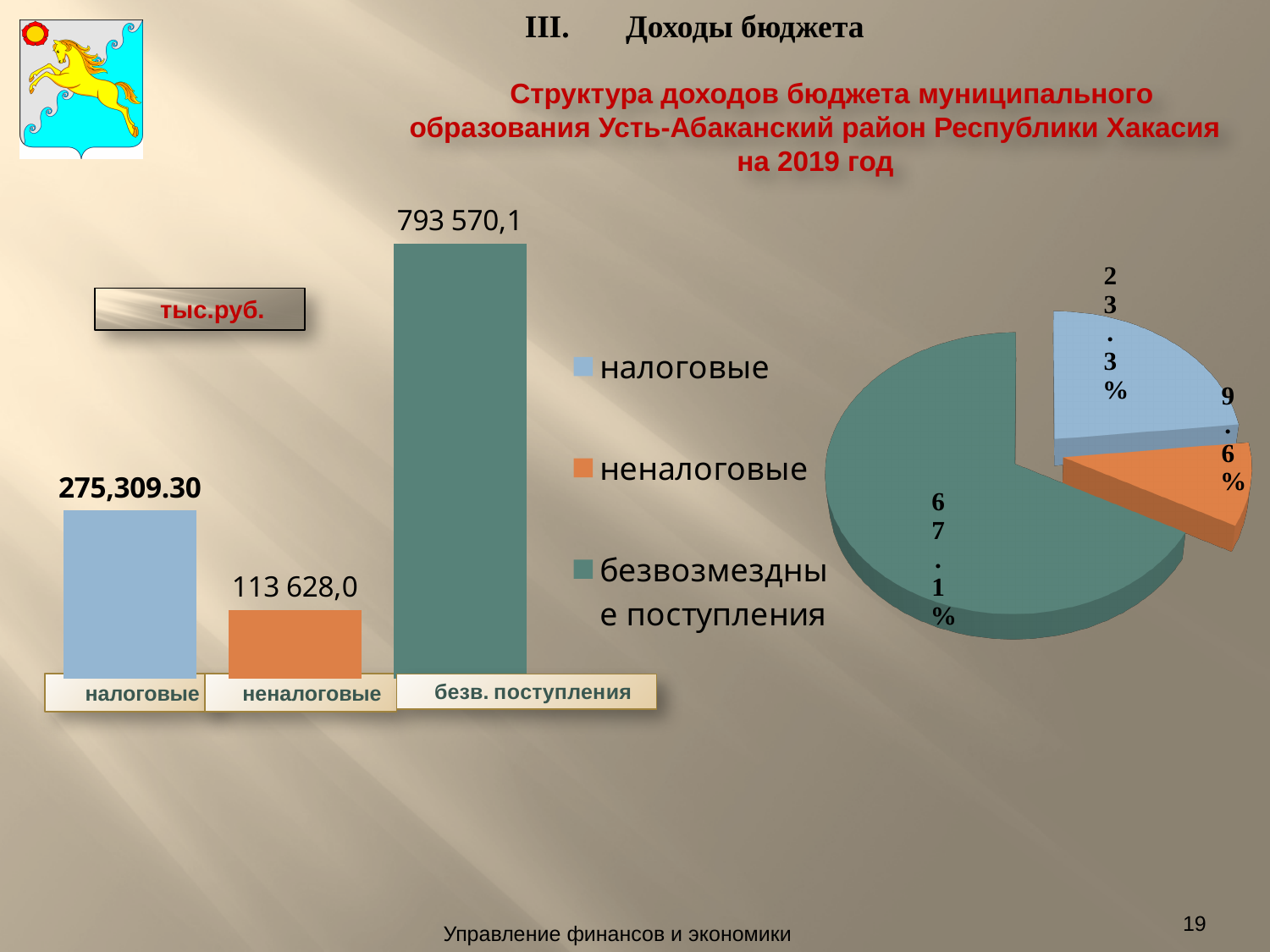
In the pie chart on the right, what share is shown for налоговые? 23.3% In the bar chart on the left, what is the value for неналоговые? 113 628,0 In the bar chart on the left, which is larger: налоговые or неналоговые? налоговые In the bar chart on the left, which category has the lowest value? неналоговые How many bars are in the bar chart on the left? 3 In the bar chart on the left, what is the difference between безв. поступления and неналоговые? 679 942,1 How many entries does the legend between the two charts list? 3 In the bar chart on the left, what is the value for безв. поступления? 793 570,1 In the bar chart on the left, which category has the highest value? безв. поступления In the bar chart on the left, what is the value for налоговые? 275,309.30 In the pie chart on the right, what share is shown for безвозмездные поступления? 67.1% What kind of chart is the chart on the left of the slide? bar chart